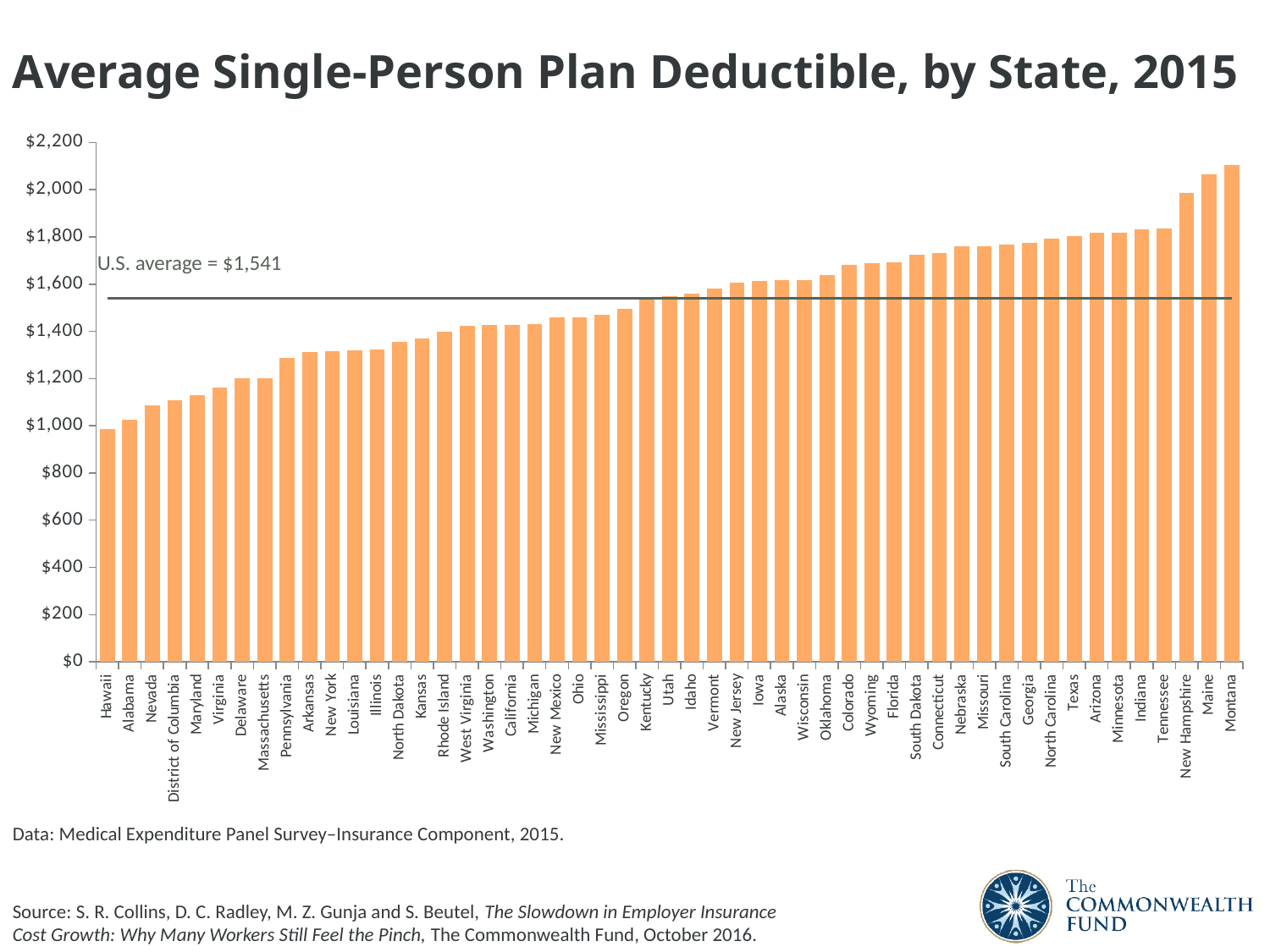
What type of chart is shown on the slide? Bar chart What colour are the bars in the chart? Orange How many states (including the District of Columbia) are plotted on the chart? 51 Which state has the highest average single-person plan deductible? Montana Is the value for Kentucky greater or less than $1,600? less Which state has the lowest average single-person plan deductible? Hawaii Is the value for Pennsylvania greater or less than $1,200? greater Is the value for Montana greater or less than $2,000? greater What is the U.S. average single-person plan deductible shown on the chart? $1,541 Do the bar values rise or fall moving from left to right along the x axis? Rise Which has a higher average deductible, Florida or Virginia? Florida